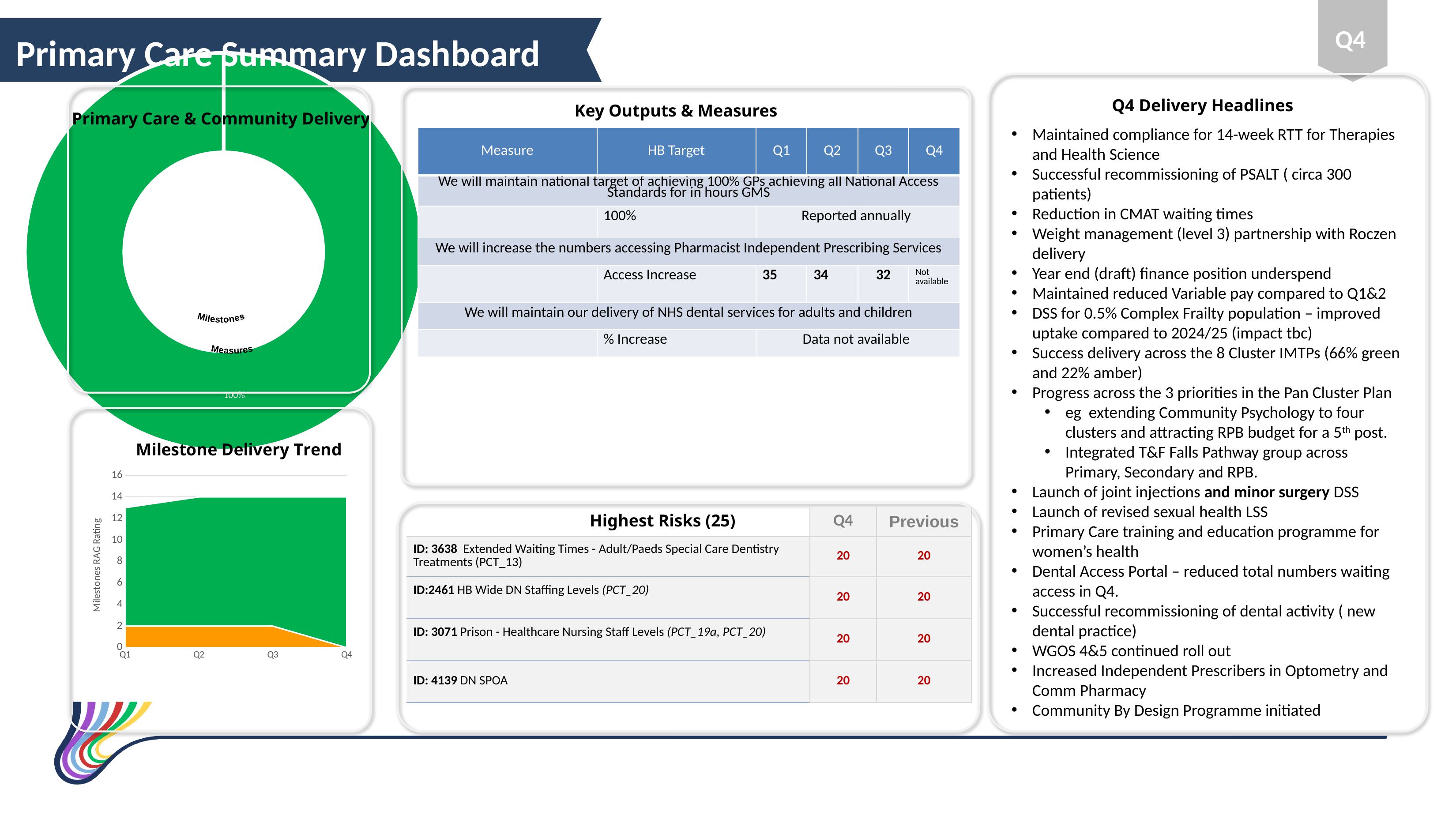
In the Milestone Delivery Trend chart, does the orange (amber) area rise or fall between Q3 and Q4? fall In the Milestone Delivery Trend chart, what is the highest value shown on the vertical axis? 16 In the Primary Care & Community Delivery chart, what percentage is shown for the green segment? 100% In the Milestone Delivery Trend chart, which quarter has the lowest orange (amber) value? Q4 What kind of chart is the Milestone Delivery Trend chart? area chart In the Milestone Delivery Trend chart, is the top of the stacked area at Q1 greater or less than 10? greater In the Milestone Delivery Trend chart, what is the label on the vertical axis? Milestones RAG Rating How many quarters are plotted along the x axis of the Milestone Delivery Trend chart? 4 What kind of chart is the Primary Care & Community Delivery chart? doughnut chart In the Milestone Delivery Trend chart, is the orange (amber) value at Q1 greater or less than 4? less In the Milestone Delivery Trend chart, is the top of the stacked area at Q4 greater or less than 12? greater